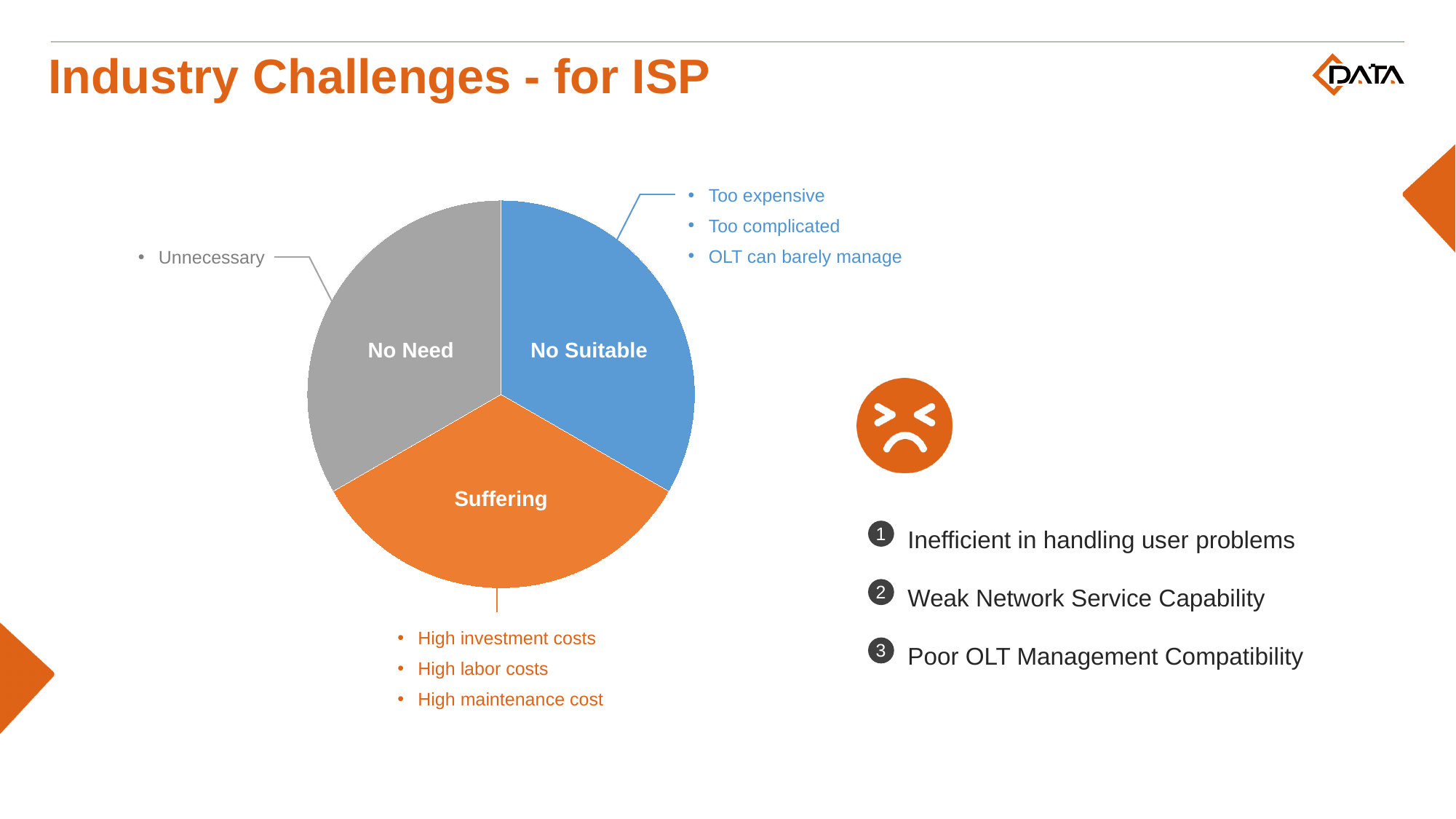
How many bullet points are attached to the 'No Need' slice of the pie chart? 1 Which slice of the pie chart is annotated with 'High investment costs', 'High labor costs' and 'High maintenance cost'? Suffering What are the labels of the three slices in the pie chart? No Need, No Suitable, Suffering Which slice of the pie chart is annotated with 'Unnecessary'? No Need How many slices does the pie chart have? 3 Which slice of the pie chart is coloured orange? Suffering How many bullet points are attached to the 'Suffering' slice of the pie chart? 3 Which slice of the pie chart is coloured gray? No Need What kind of chart is shown on the slide? Pie chart Which slice of the pie chart is annotated with 'Too expensive', 'Too complicated' and 'OLT can barely manage'? No Suitable Which slice of the pie chart is coloured blue? No Suitable